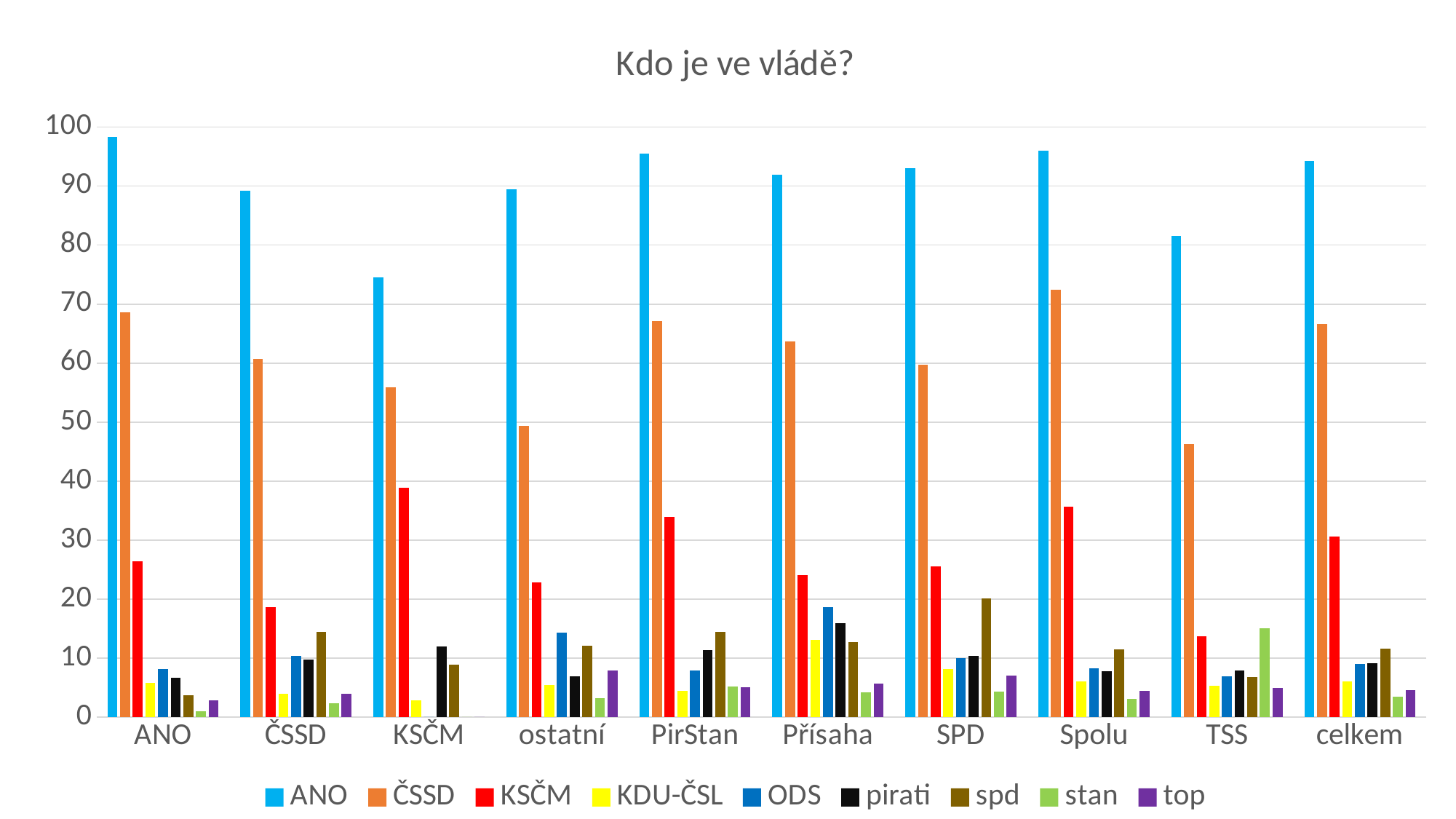
Which category has the lowest value for the ANO series? KSČM How many categories are shown on the x axis? 10 Is the KSČM value for the Spolu category greater or less than 30? greater Which is larger for the SPD category: the ČSSD value or the spd value? ČSSD How many series does the legend list? 9 Which category has the highest value for the stan series? TSS Which category has the highest value for the ANO series? ANO What kind of chart is shown on the slide? bar chart Is the ANO value for the TSS category greater or less than 80? greater What is the title of the chart? Kdo je ve vládě? Which category has the highest value for the KSČM series? KSČM